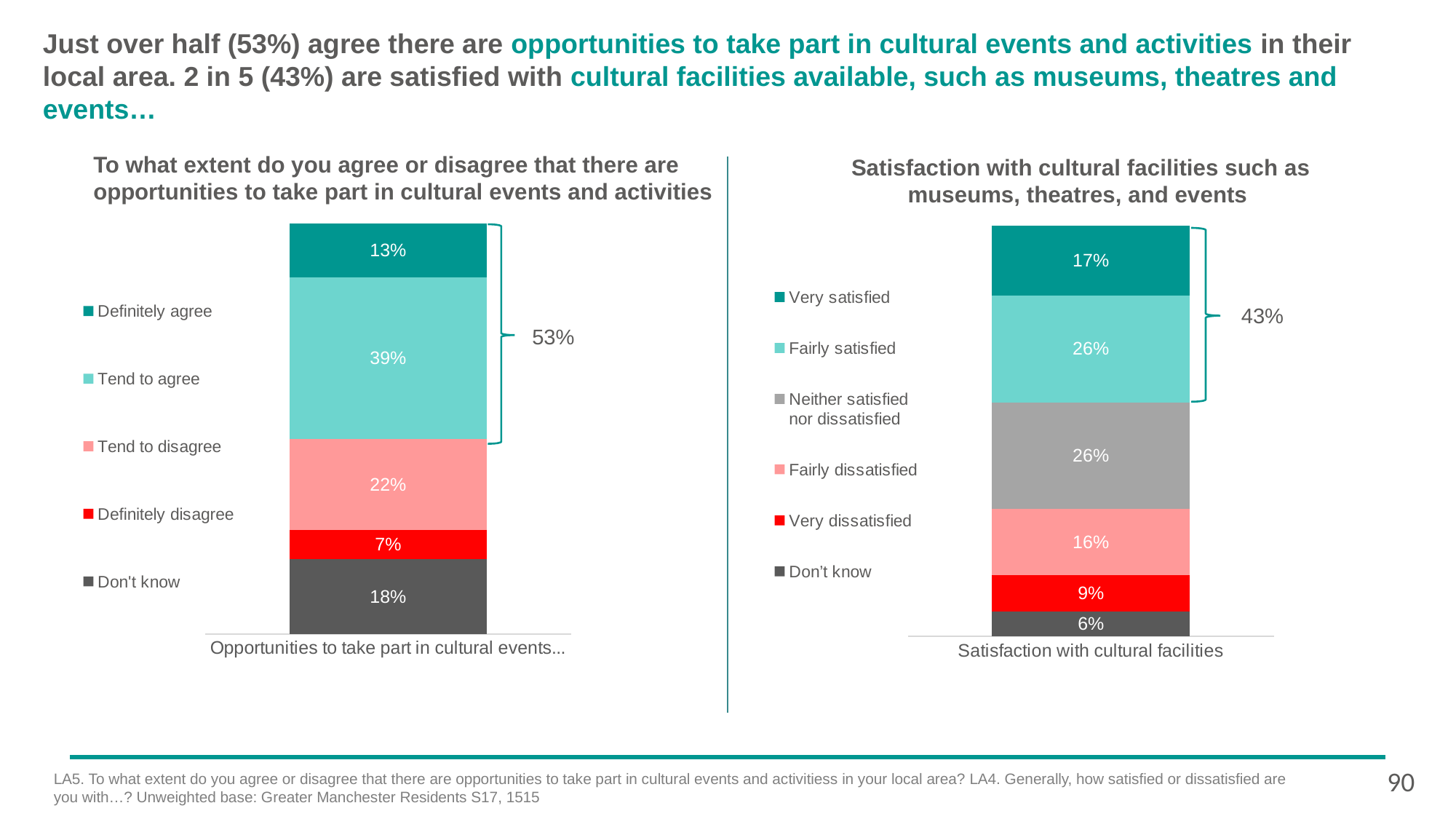
In the left chart on opportunities to take part in cultural events, which response category has the largest share? Tend to agree What type of chart is used on the left to show opportunities to take part in cultural events? Stacked bar chart In the left chart on opportunities to take part in cultural events, what is the difference between 'Tend to disagree' and 'Definitely disagree'? 15% In the right chart on satisfaction with cultural facilities, what percentage are 'Very satisfied'? 17% In the right chart on satisfaction with cultural facilities, what percentage are 'Very dissatisfied'? 9% In the right chart on satisfaction with cultural facilities, what is the total of all the segments in the stacked bar? 100% In the right chart on satisfaction with cultural facilities, which is larger: 'Fairly dissatisfied' or 'Very satisfied'? Very satisfied What combined percentage is shown by the bracket next to the right chart on satisfaction with cultural facilities? 43% In the left chart on opportunities to take part in cultural events, what percentage answered 'Don't know'? 18% In the left chart on opportunities to take part in cultural events, what percentage of respondents 'Tend to agree'? 39% In the left chart on opportunities to take part in cultural events, which response category has the smallest share? Definitely disagree How many response categories does the legend of the right chart on satisfaction with cultural facilities list? 6